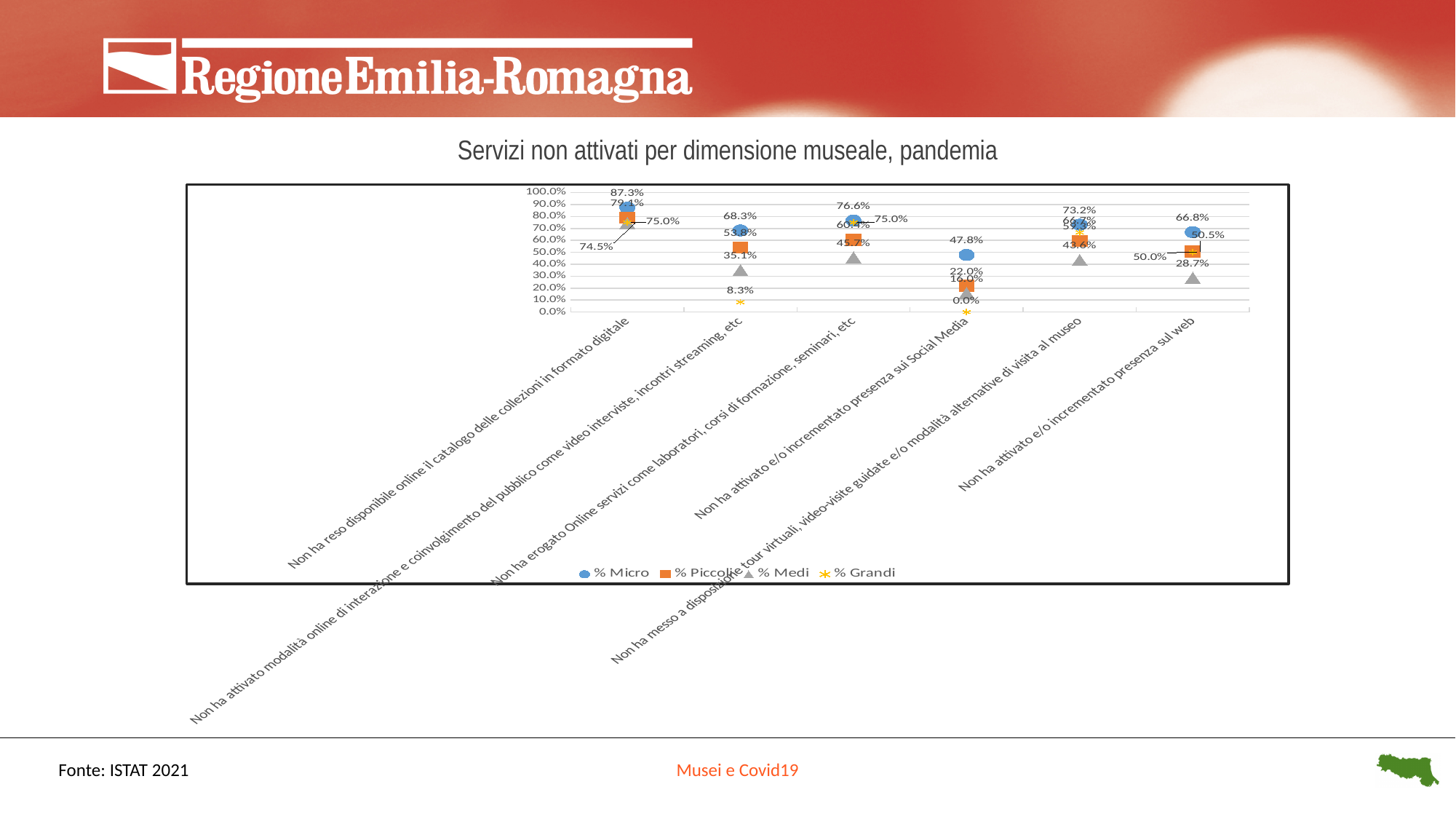
How many categories are shown on the x axis of the chart? 6 For 'Non ha attivato e/o incrementato presenza sul web', what is the difference between the % Micro value and the % Piccole value? 16.3 percentage points What is the % Micro value for 'Non ha reso disponibile online il catalogo delle collezioni in formato digitale'? 87.3% How many series does the chart legend list? 4 What is the % Grandi value for 'Non ha attivato e/o incrementato presenza sui Social Media'? 0.0% Which category has the lowest % Micro value? Non ha attivato e/o incrementato presenza sui Social Media What is the % Grandi value for 'Non ha attivato modalità online di interazione e coinvolgimento del pubblico come video interviste, incontri streaming, etc'? 8.3% What is the % Medi value for 'Non ha attivato e/o incrementato presenza sul web'? 28.7% What is the title of the chart? Servizi non attivati per dimensione museale, pandemia Is the % Micro value for 'Non ha attivato e/o incrementato presenza sui Social Media' greater or less than 50.0%? less Which is larger: the % Micro value for 'Non ha reso disponibile online il catalogo delle collezioni in formato digitale' or the % Micro value for 'Non ha erogato Online servizi come laboratori, corsi di formazione, seminari, etc'? Non ha reso disponibile online il catalogo delle collezioni in formato digitale Which category has the highest % Micro value? Non ha reso disponibile online il catalogo delle collezioni in formato digitale